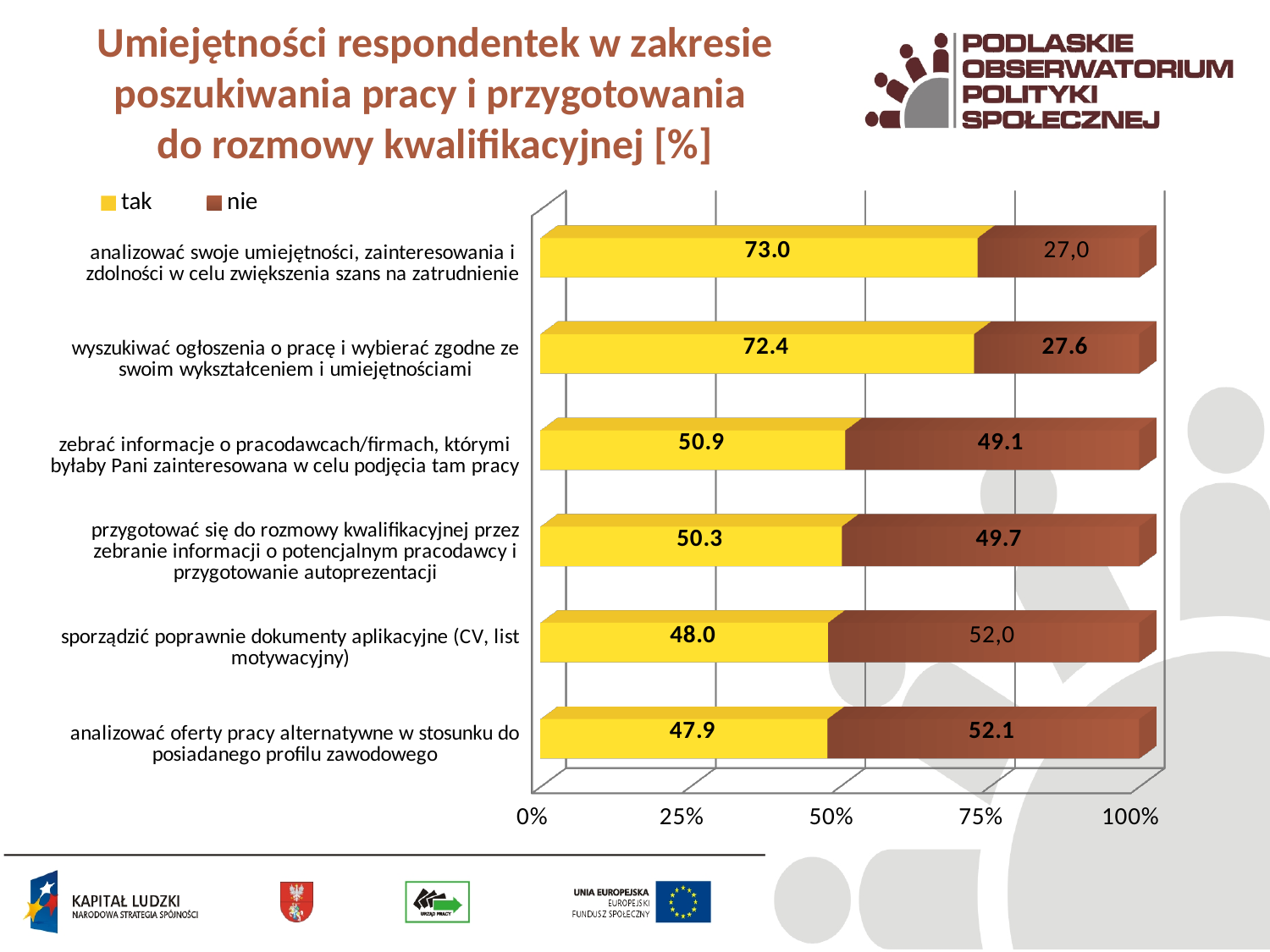
What type of chart is shown on the slide? bar chart How many categories are plotted in the chart? 6 What is the total of the stacked bar for 'przygotować się do rozmowy kwalifikacyjnej przez zebranie informacji o potencjalnym pracodawcy i przygotowanie autoprezentacji'? 100.0 What is the difference between the 'nie' and 'tak' values for 'analizować oferty pracy alternatywne w stosunku do posiadanego profilu zawodowego'? 4.2 What is the 'tak' value for 'analizować swoje umiejętności, zainteresowania i zdolności w celu zwiększenia szans na zatrudnienie'? 73.0 Which colour represents the 'nie' series in the chart? brown What is the 'tak' value for 'sporządzić poprawnie dokumenty aplikacyjne (CV, list motywacyjny)'? 48.0 Which is larger for 'zebrać informacje o pracodawcach/firmach, którymi byłaby Pani zainteresowana w celu podjęcia tam pracy': the 'tak' value or the 'nie' value? tak Which category has the lowest 'tak' value? analizować oferty pracy alternatywne w stosunku do posiadanego profilu zawodowego How many series does the legend list? 2 Which category has the highest 'tak' value? analizować swoje umiejętności, zainteresowania i zdolności w celu zwiększenia szans na zatrudnienie What is the 'nie' value for 'wyszukiwać ogłoszenia o pracę i wybierać zgodne ze swoim wykształceniem i umiejętnościami'? 27.6